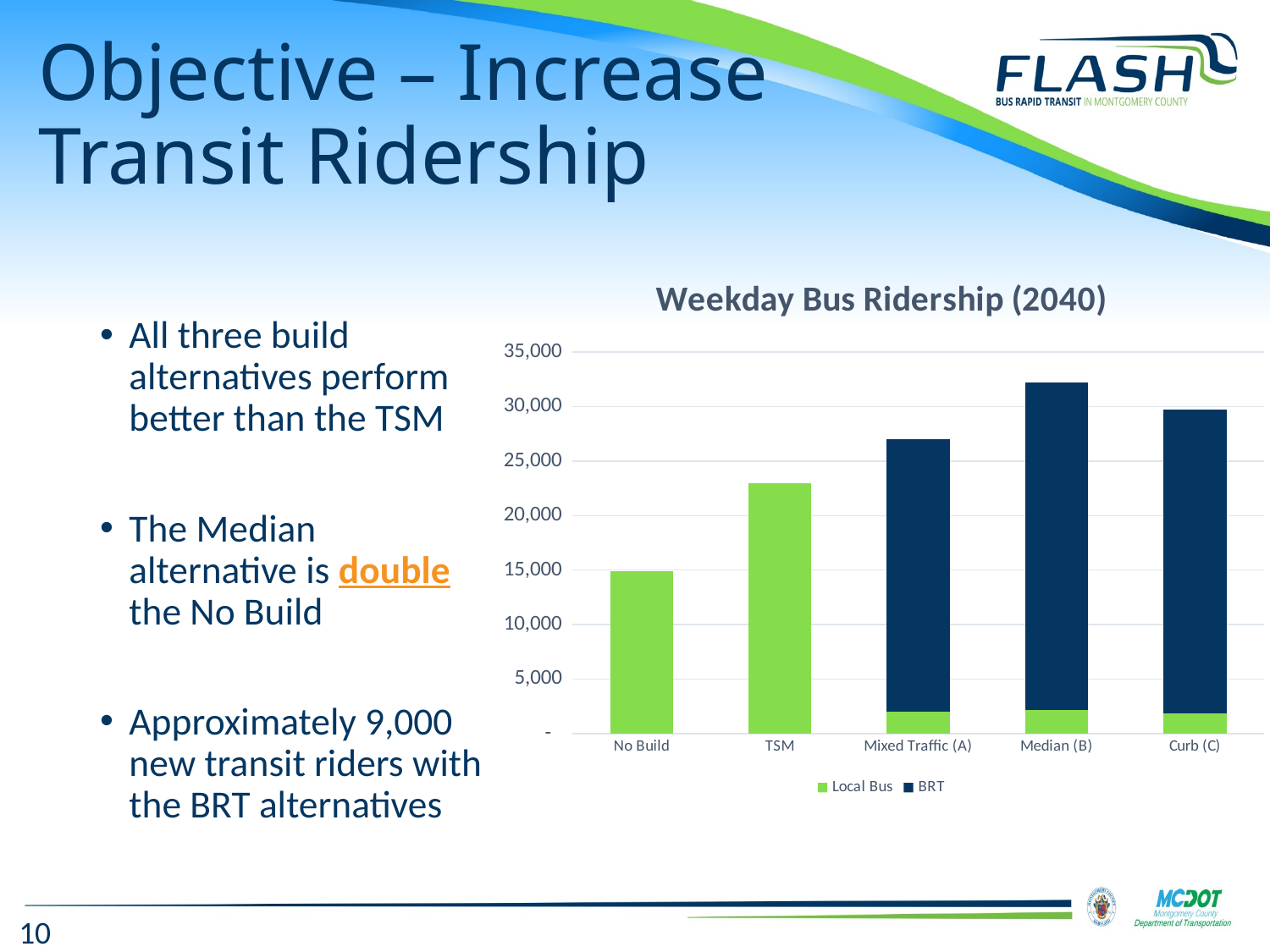
Which series are listed in the chart's legend? Local Bus and BRT Which has a larger total ridership, Median (B) or Curb (C)? Median (B) Which category has the highest total weekday bus ridership? Median (B) Which category has the lowest total weekday bus ridership? No Build How many categories are shown on the x axis of the chart? 5 What kind of chart is shown on the slide? Stacked bar chart Is the total value for TSM greater or less than 20,000? greater What is the title of the chart? Weekday Bus Ridership (2040) Is the total value for Median (B) greater or less than 30,000? greater How many series does the chart's legend list? 2 Which has a larger total ridership, TSM or Mixed Traffic (A)? Mixed Traffic (A) Is the total value for No Build greater or less than 20,000? less